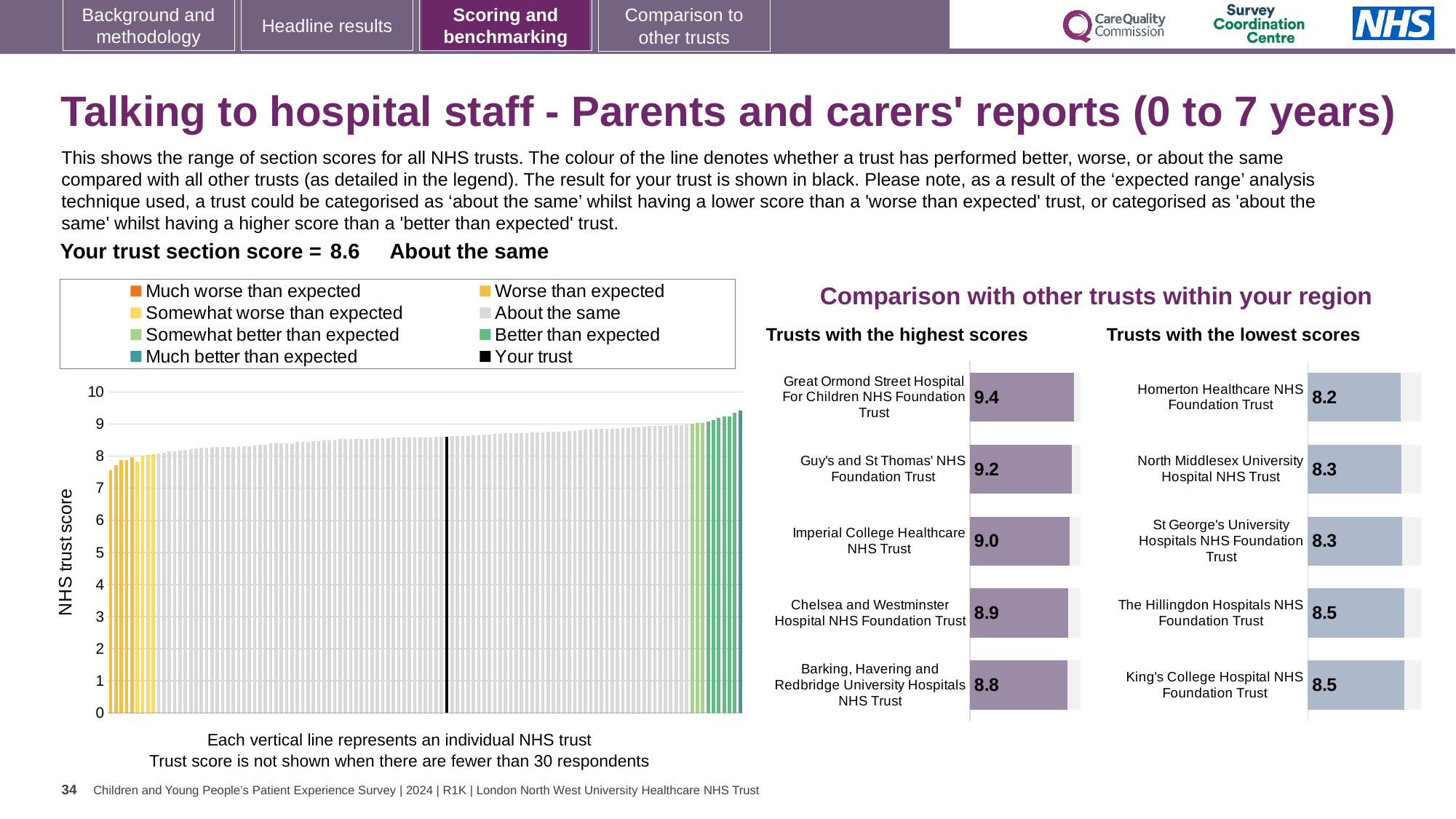
In the 'Trusts with the highest scores' chart, what is the score for Great Ormond Street Hospital For Children NHS Foundation Trust? 9.4 In the 'Trusts with the lowest scores' chart, which has the larger score: North Middlesex University Hospital NHS Trust or King's College Hospital NHS Foundation Trust? King's College Hospital NHS Foundation Trust In the 'Trusts with the highest scores' chart, which trust has the highest score? Great Ormond Street Hospital For Children NHS Foundation Trust How many trusts are shown in the 'Trusts with the highest scores' chart? 5 In the large chart on the left showing all NHS trusts, is the value for the black 'Your trust' bar greater or less than 8? greater What type of chart is the large chart on the left showing all NHS trusts? Bar chart In the 'Trusts with the highest scores' chart, what is the score for Imperial College Healthcare NHS Trust? 9.0 In the 'Trusts with the lowest scores' chart, what is the score for Homerton Healthcare NHS Foundation Trust? 8.2 In the 'Trusts with the highest scores' chart, what is the difference between the scores of Great Ormond Street Hospital For Children NHS Foundation Trust and Barking, Havering and Redbridge University Hospitals NHS Trust? 0.6 How many entries does the legend of the large chart on the left list? 8 In the 'Trusts with the lowest scores' chart, what is the score for The Hillingdon Hospitals NHS Foundation Trust? 8.5 In the 'Trusts with the lowest scores' chart, which trust has the lowest score? Homerton Healthcare NHS Foundation Trust